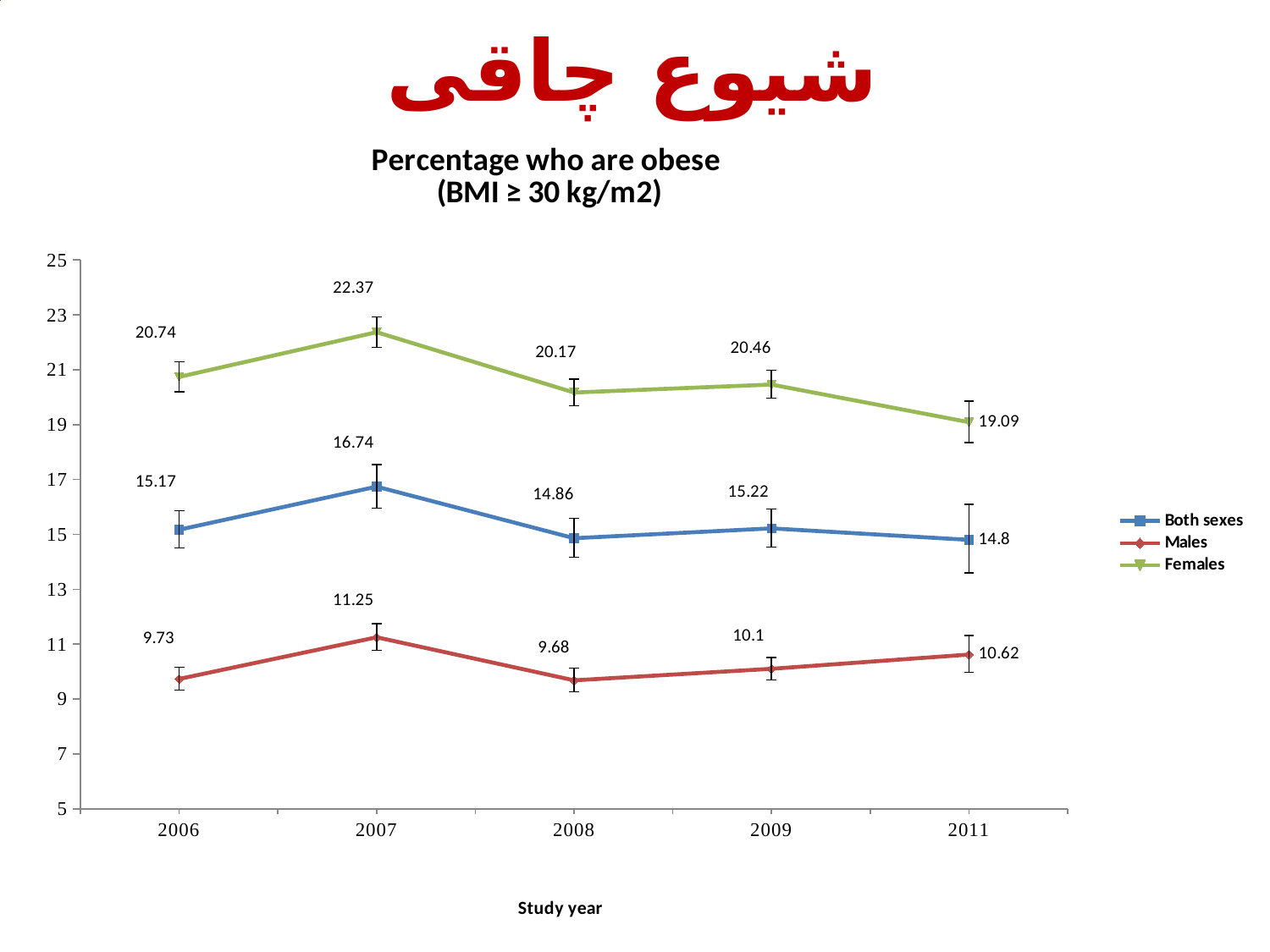
What is the value for Both sexes in 2008? 14.86 Which is larger, the Both sexes value in 2007 or in 2009? 2007 What is the value for Males in 2011? 10.62 How many study years are shown on the x axis? 5 What is the difference between the Females and Males values in 2006? 11.01 In which study year is the Males value highest? 2007 In which study year is the Females value lowest? 2011 How many series does the legend list? 3 Is the value for Females in 2011 greater or less than 21? less What is the value for Females in 2007? 22.37 What is the x-axis title of the chart? Study year What kind of chart is shown on the slide? line chart